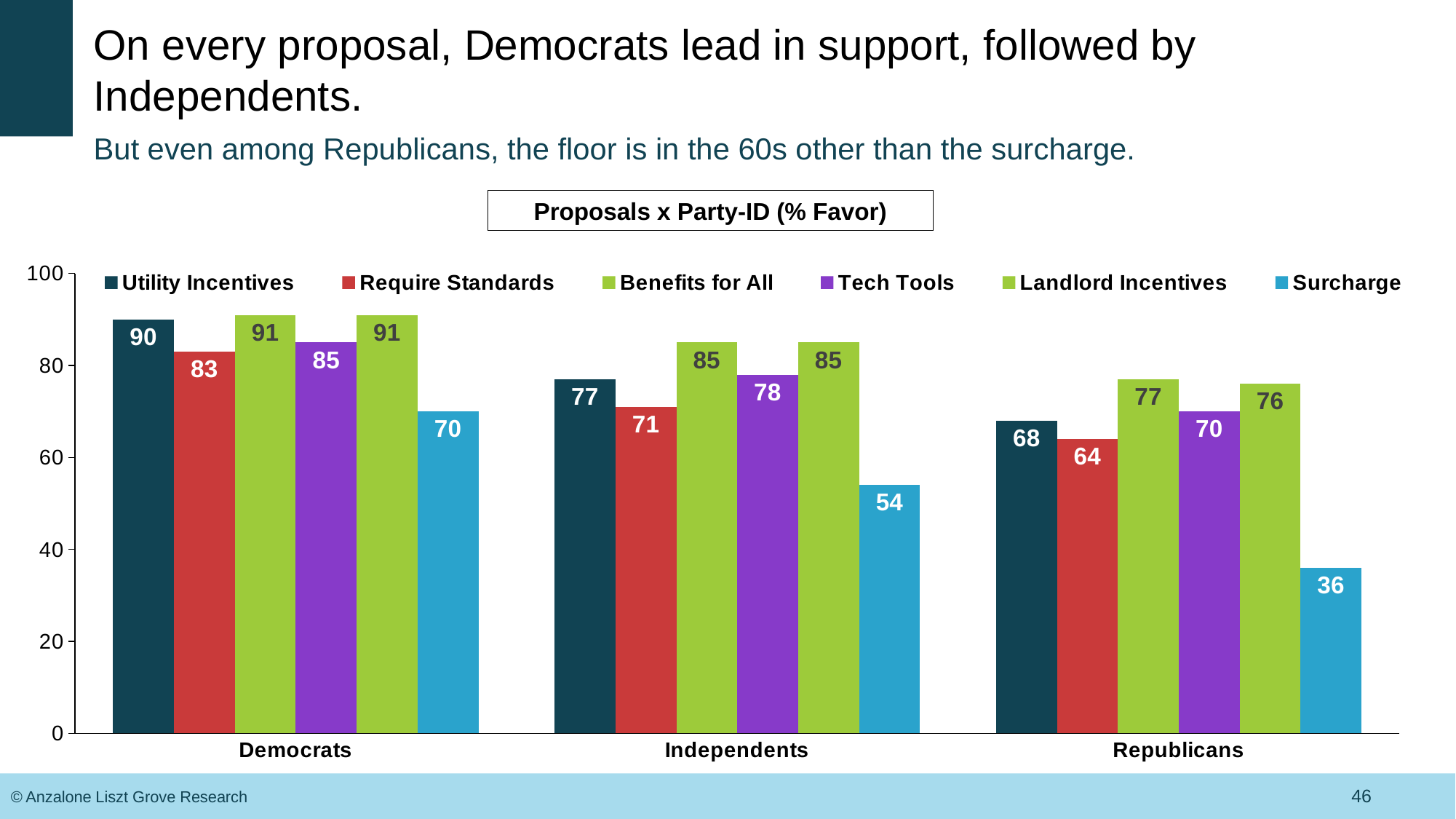
What is the value for Require Standards among Republicans? 64 Which is larger: Tech Tools among Democrats or Tech Tools among Republicans? Tech Tools among Democrats What is the value for Tech Tools among Independents? 78 What kind of chart is shown on the slide? Bar chart What is the value for Surcharge among Republicans? 36 What is the value for Utility Incentives among Democrats? 90 What is the title of the chart? Proposals x Party-ID (% Favor) Which party group has the highest value for Utility Incentives? Democrats Which party group has the lowest value for Surcharge? Republicans How many party groups are shown on the x axis? 3 What is the difference between the Surcharge values for Democrats and Republicans? 34 How many series does the legend list? 6